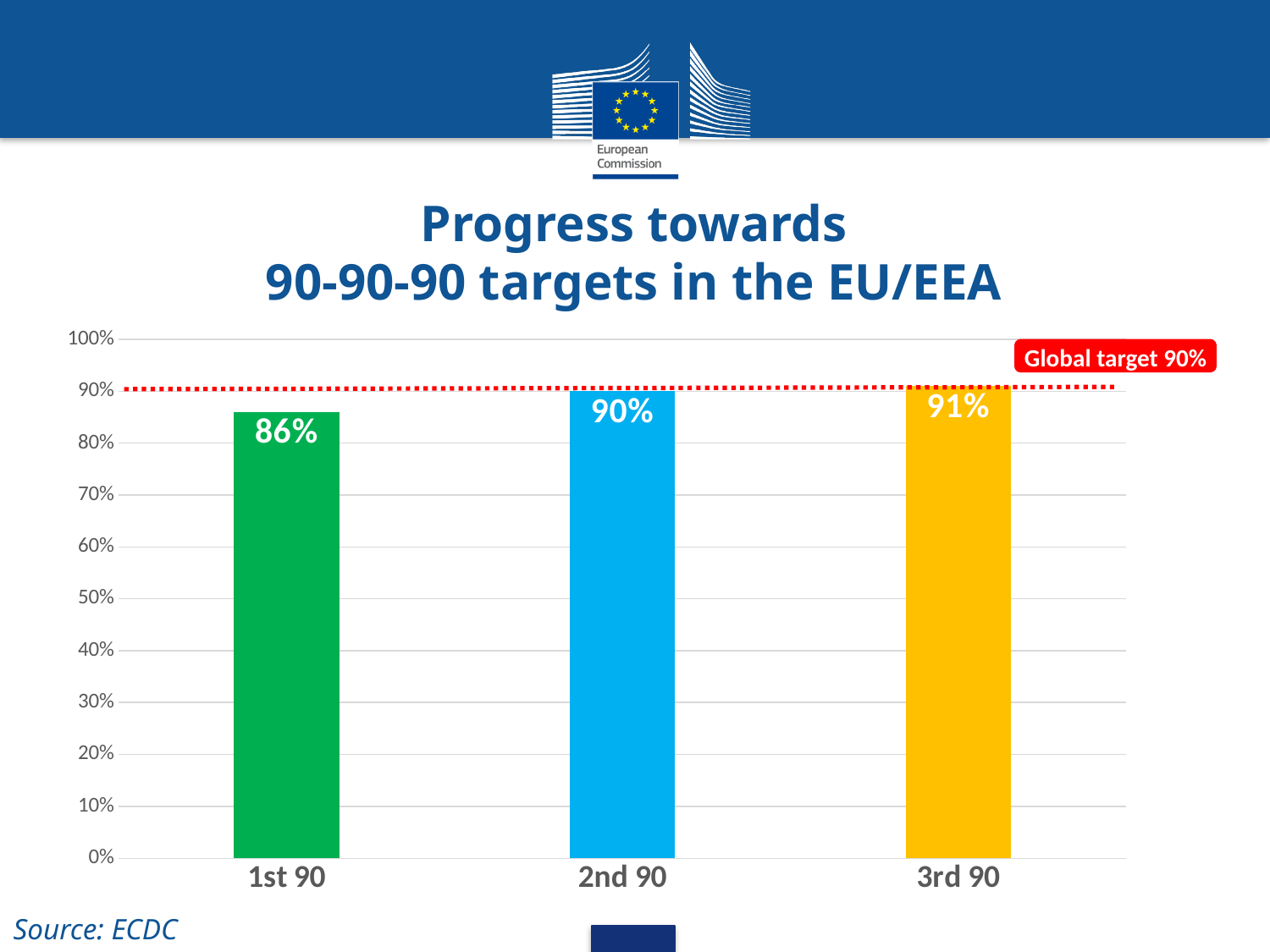
Do the values rise or fall from 1st 90 to 3rd 90? rise What is the value for 1st 90? 86% What is the value for 3rd 90? 91% Is the value for 1st 90 greater or less than 90%? less What is the difference between the values for 3rd 90 and 1st 90? 5% What global target does the dashed red line mark? Global target 90% What is the value for 2nd 90? 90% Which is larger, the value for 1st 90 or the value for 2nd 90? 2nd 90 Which category has the highest value? 3rd 90 Which category has the lowest value? 1st 90 How many categories are shown on the x axis? 3 What kind of chart is shown on the slide? bar chart